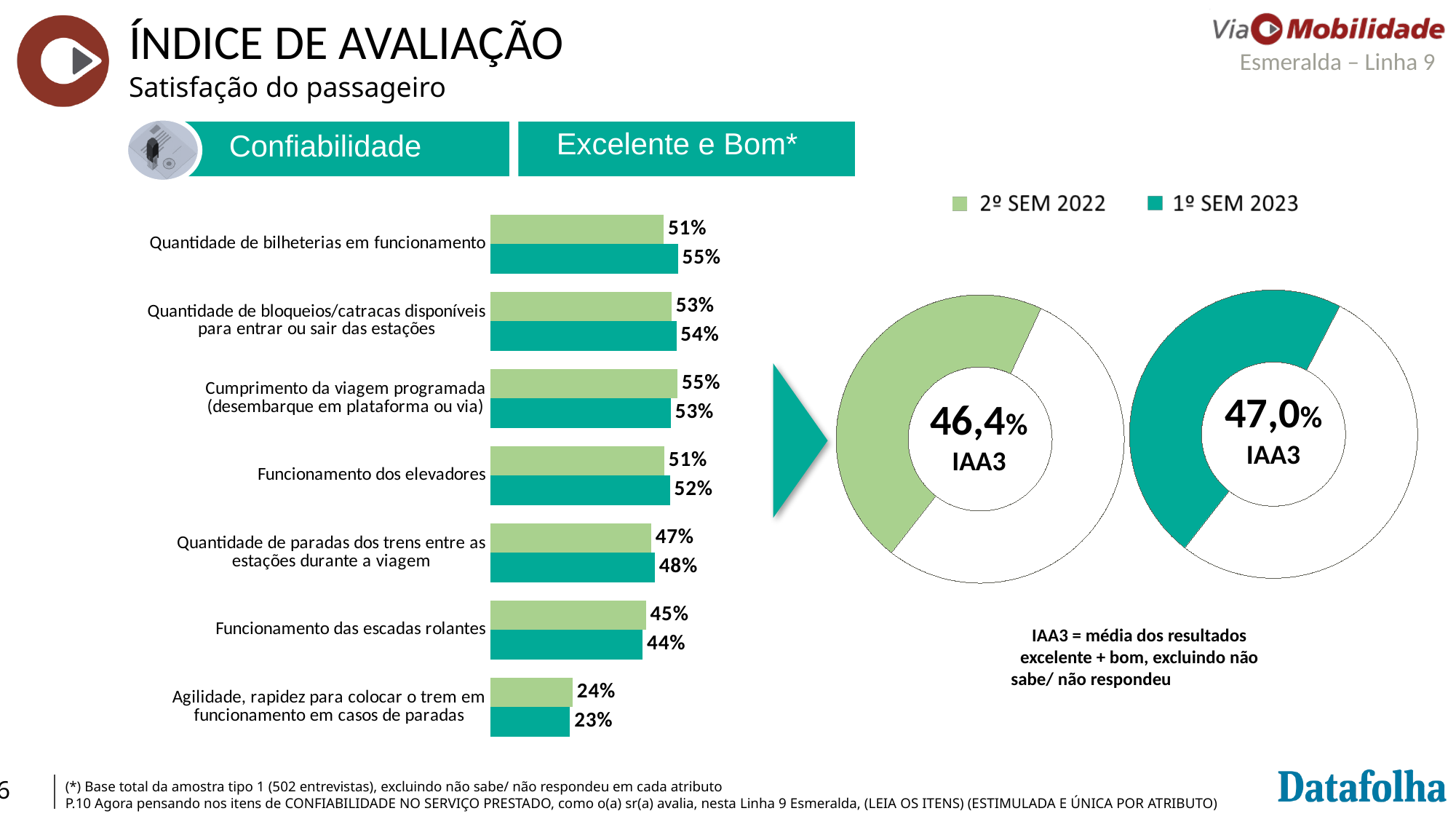
How many series does the legend of the bar chart list? 2 How many categories does the bar chart show? 7 In the donut chart for 1º SEM 2023, what is the IAA3 value? 47,0% In the donut chart for 2º SEM 2022, what is the IAA3 value? 46,4% In the bar chart, what is the value for 'Funcionamento das escadas rolantes' in 2º SEM 2022? 45% In the bar chart, which category has the lowest value in 2º SEM 2022? Agilidade, rapidez para colocar o trem em funcionamento em casos de paradas In the bar chart, for 'Cumprimento da viagem programada (desembarque em plataforma ou via)', which is larger: the 2º SEM 2022 value or the 1º SEM 2023 value? 2º SEM 2022 In the bar chart, what is the difference between the 1º SEM 2023 and 2º SEM 2022 values for 'Quantidade de bilheterias em funcionamento'? 4 percentage points In the bar chart, which category has the highest value in 1º SEM 2023? Quantidade de bilheterias em funcionamento What kind of chart is used on the left side of the slide to show the attribute ratings? Bar chart In the bar chart, what is the value for 'Quantidade de bilheterias em funcionamento' in 1º SEM 2023? 55% In the bar chart, what is the value for 'Agilidade, rapidez para colocar o trem em funcionamento em casos de paradas' in 1º SEM 2023? 23%